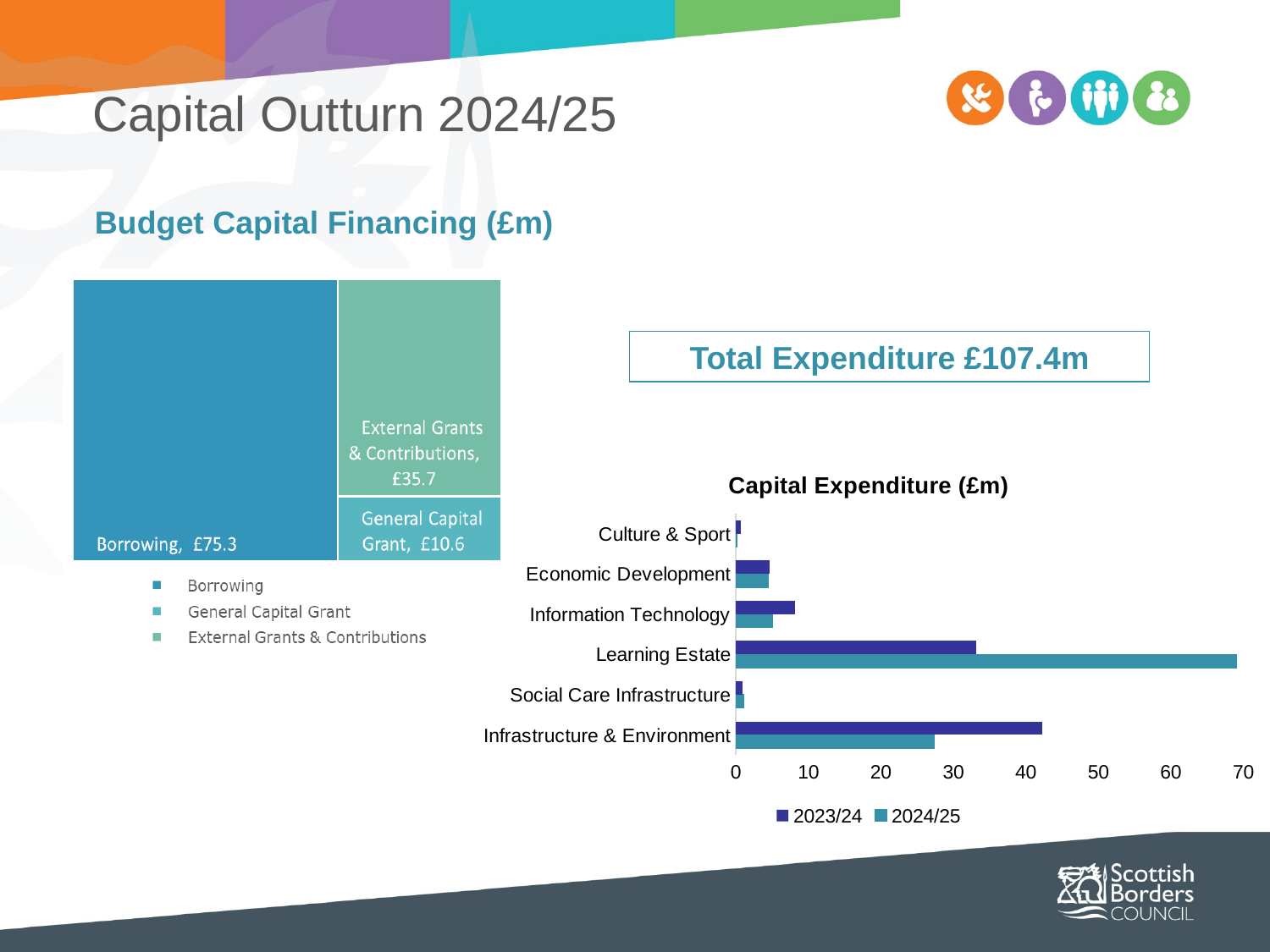
In the Capital Expenditure (£m) chart, which category has the highest 2024/25 value? Learning Estate In the Capital Expenditure (£m) chart, is the 2024/25 value for Learning Estate greater or less than 60? greater What kind of chart is the Capital Expenditure (£m) chart? Bar chart In the Budget Capital Financing (£m) chart, which category has the largest value? Borrowing In the Budget Capital Financing (£m) chart, what is the difference between Borrowing and External Grants & Contributions? £39.6 In the Budget Capital Financing (£m) chart, what is the value for External Grants & Contributions? £35.7 In the Capital Expenditure (£m) chart, which is larger for Infrastructure & Environment, the 2023/24 value or the 2024/25 value? 2023/24 How many categories are shown in the Budget Capital Financing (£m) chart? 3 How many series does the legend of the Capital Expenditure (£m) chart list? 2 In the Budget Capital Financing (£m) chart, what is the value for General Capital Grant? £10.6 In the Budget Capital Financing (£m) chart, what is the value for Borrowing? £75.3 In the Budget Capital Financing (£m) chart, which category has the smallest value? General Capital Grant